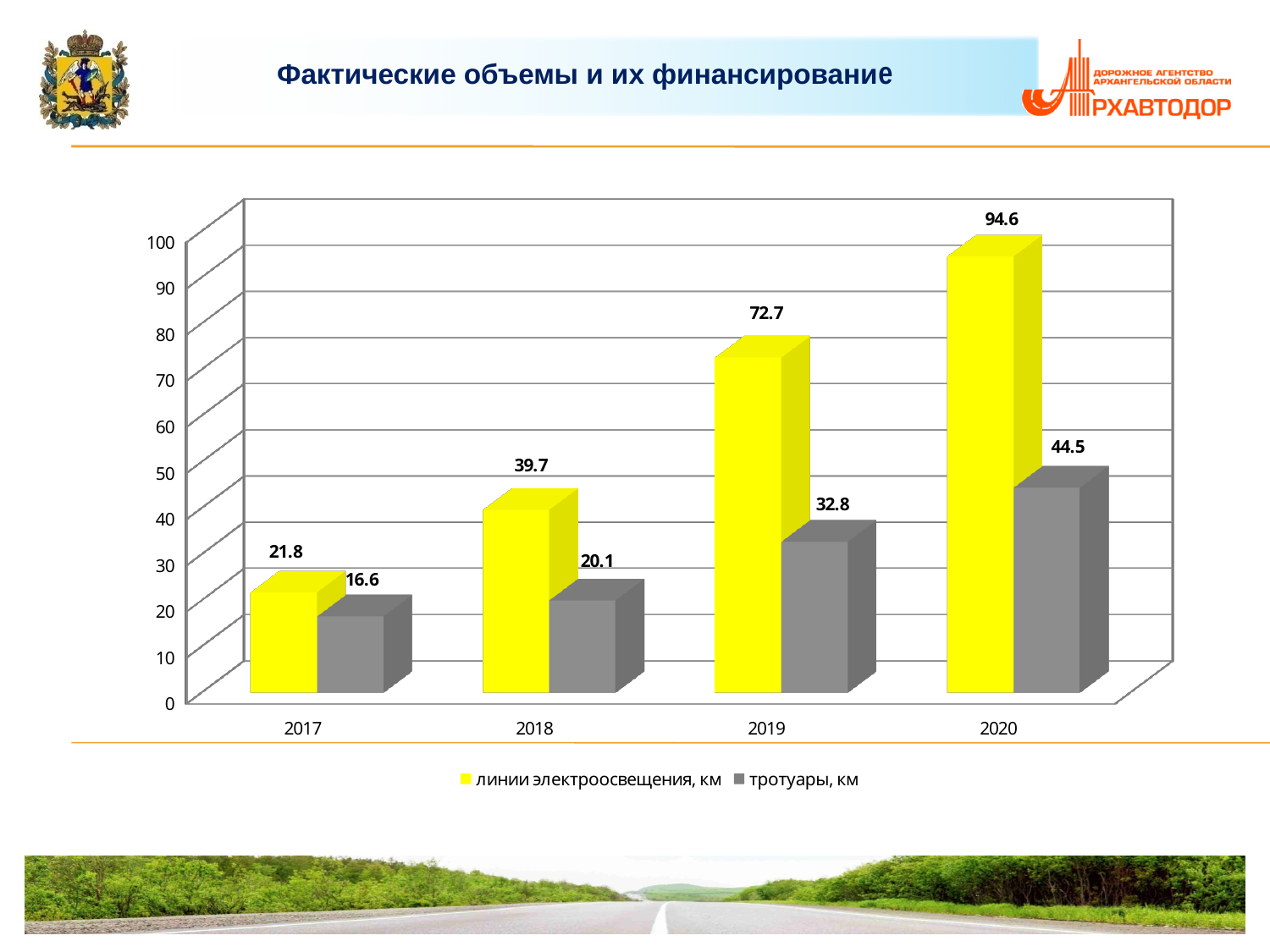
What is the value for тротуары, км in 2017? 16.6 What is the difference between линии электроосвещения, км and тротуары, км in 2020? 50.1 In which year is the value for линии электроосвещения, км highest? 2020 Do the values for тротуары, км rise or fall from 2017 to 2020? rise What kind of chart is shown on the slide? bar chart What is the value for тротуары, км in 2020? 44.5 In which year is the value for тротуары, км lowest? 2017 How many years are shown on the x axis? 4 Which is larger: тротуары, км in 2019 or линии электроосвещения, км in 2018? линии электроосвещения, км in 2018 What is the difference between the 2018 and 2017 values for линии электроосвещения, км? 17.9 What is the value for линии электроосвещения, км in 2019? 72.7 How many series does the legend list? 2